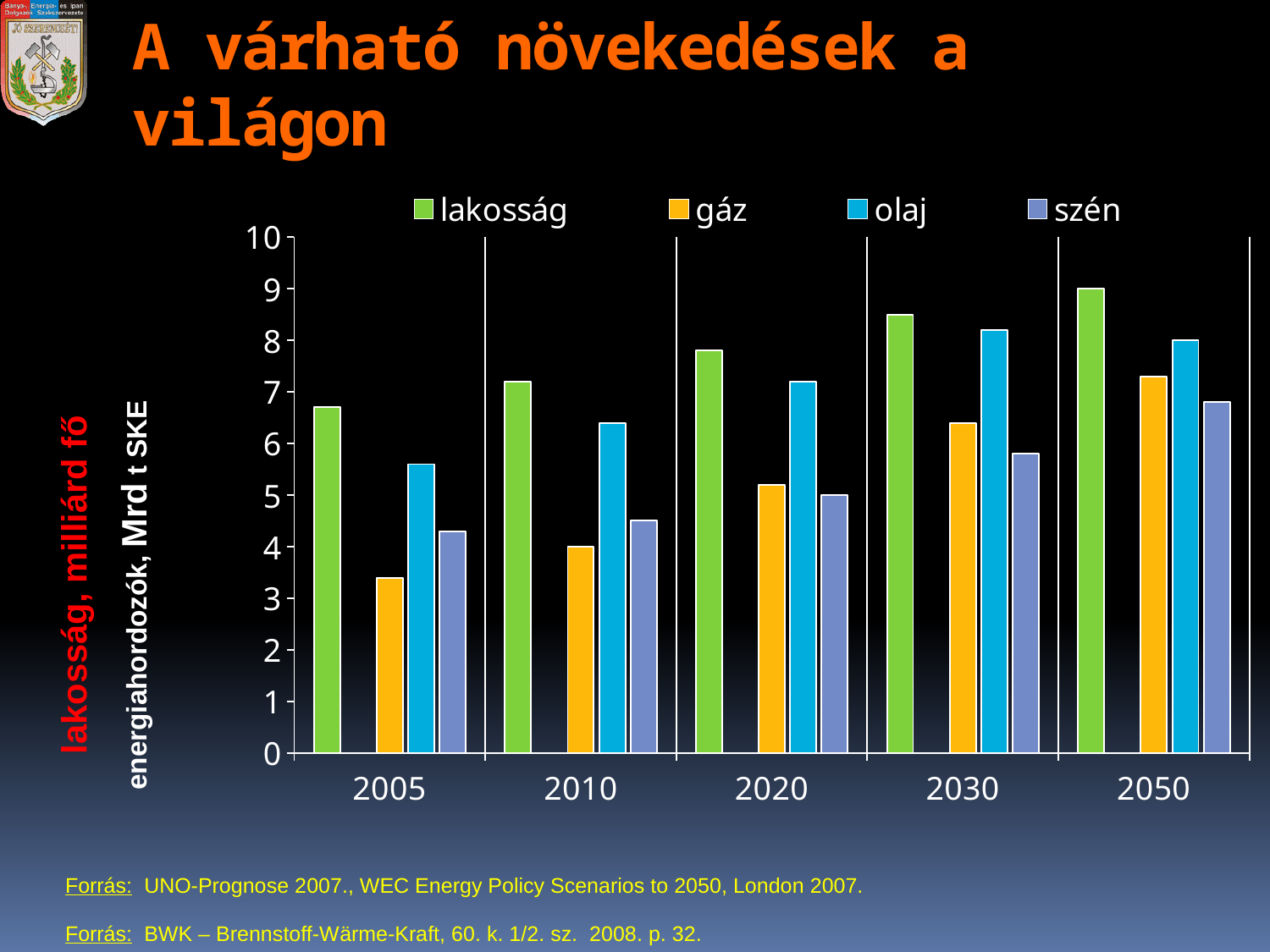
How many year categories are shown on the x axis? 5 What kind of chart is shown on the slide? bar chart In 2020, which is larger, olaj or szén? olaj Is the value for lakosság in 2050 greater or less than 8? greater In which year is the lakosság bar highest? 2050 Which series is shown in yellow in the legend? gáz How many series does the legend list? 4 Is the value for szén in 2005 greater or less than 5? less Is the value for gáz in 2005 greater or less than 4? less In which year is the gáz bar lowest? 2005 Do the lakosság values rise or fall from 2005 to 2050? rise